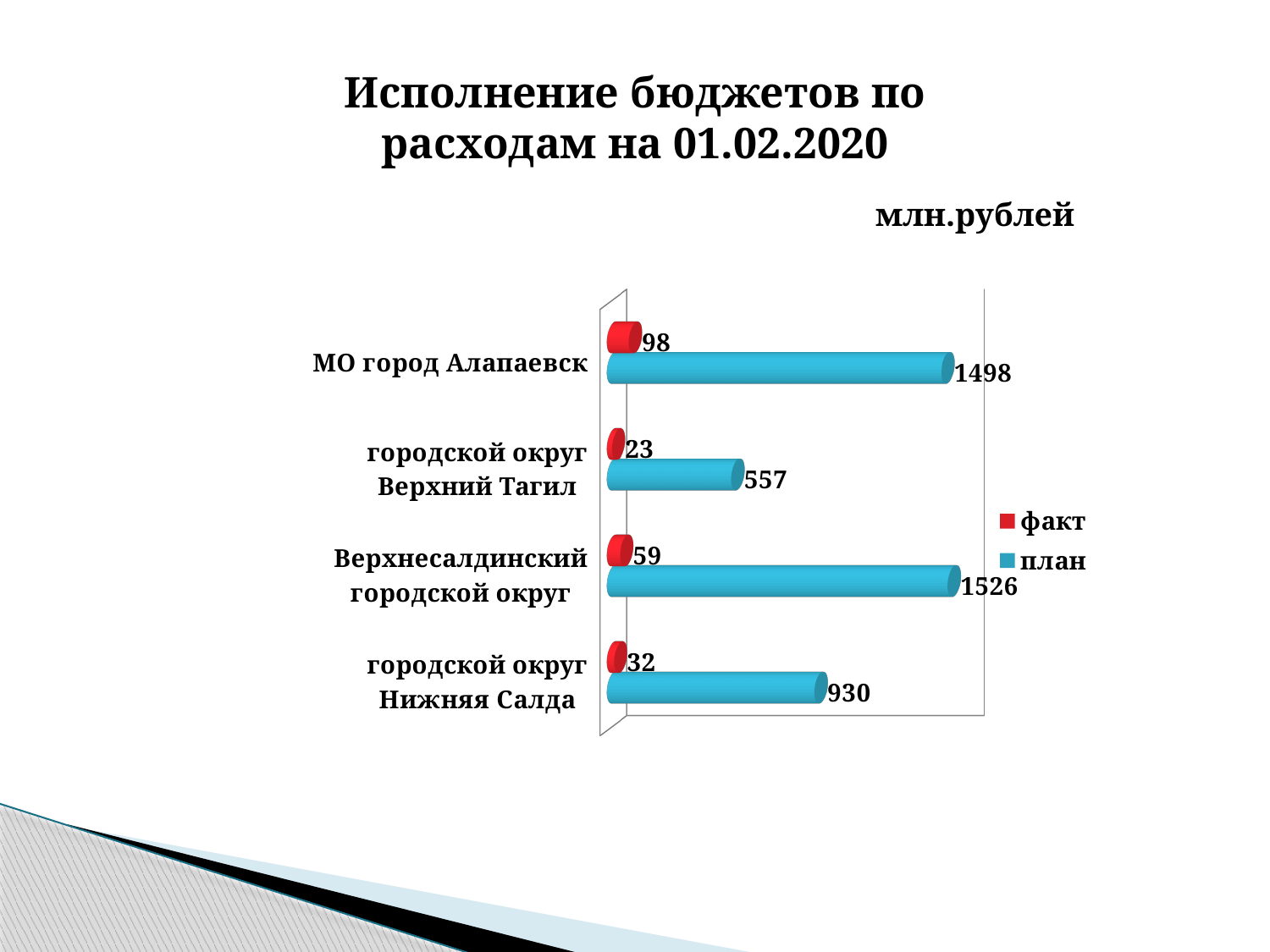
Which category has the lowest факт value? городской округ Верхний Тагил How many series does the legend list? 2 How many categories are shown in the chart? 4 What colour are the план bars? blue What is the факт value for Верхнесалдинский городской округ? 59 Which category has the highest план value? Верхнесалдинский городской округ What is the план value for МО город Алапаевск? 1498 What is the план value for городской округ Нижняя Салда? 930 What is the difference between the план and факт values for городской округ Нижняя Салда? 898 What kind of chart is shown on the slide? bar chart What is the факт value for городской округ Верхний Тагил? 23 Which is larger, the план value for МО город Алапаевск or the план value for городской округ Верхний Тагил? МО город Алапаевск